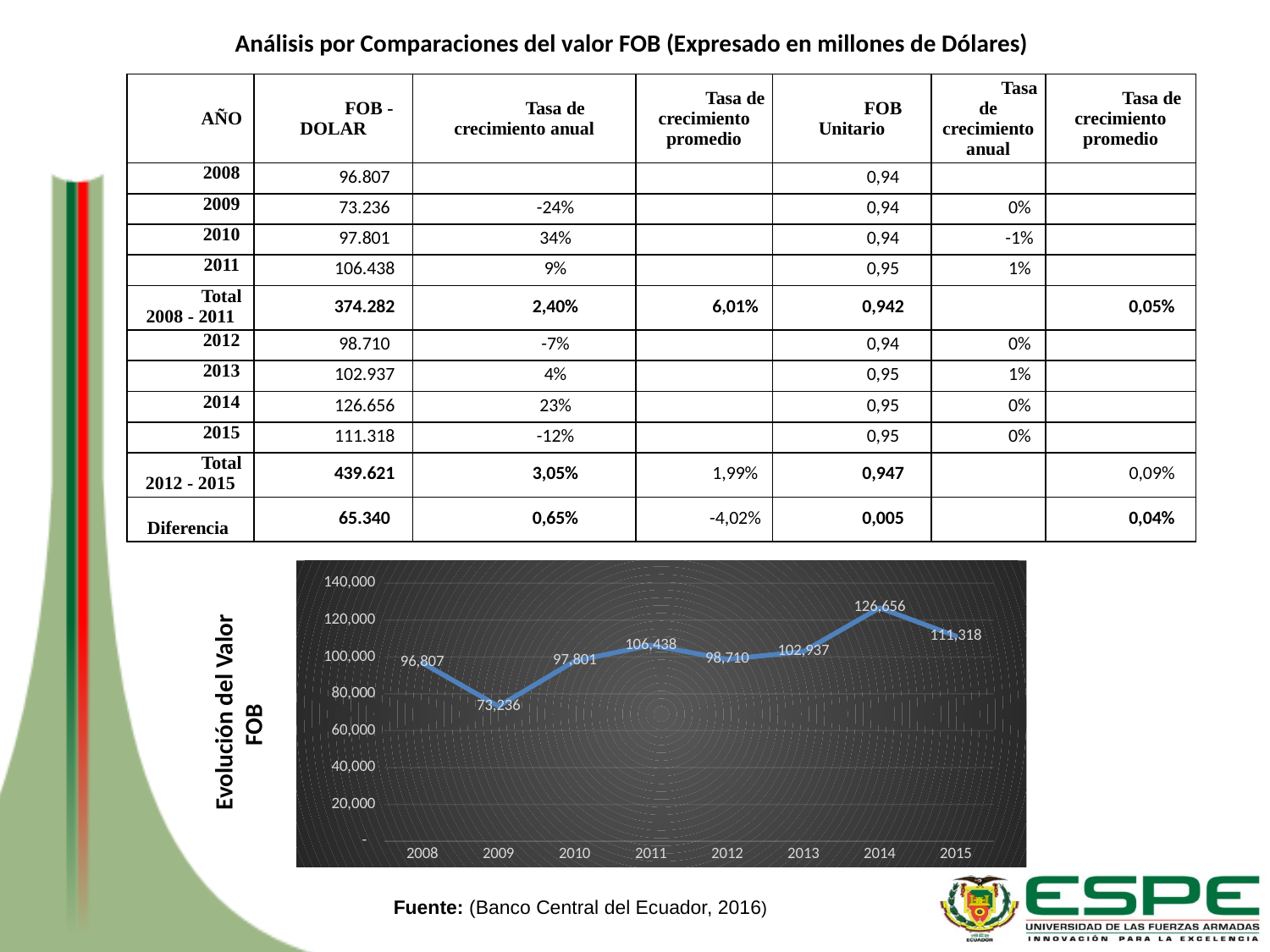
In the line chart, what is the difference between the FOB values for 2014 and 2015? 15,338 In the line chart, which year has a larger FOB value, 2010 or 2012? 2012 Which year has the highest FOB value in the line chart? 2014 What is the FOB value plotted for 2008 in the line chart? 96,807 In the line chart, is the FOB value for 2009 greater or less than 80,000? less In the line chart, does the FOB value rise or fall from 2012 to 2014? rise What is the FOB value plotted for 2014 in the line chart? 126,656 What is the title written beside the line chart? Evolución del Valor FOB What is the FOB value plotted for 2011 in the line chart? 106,438 What kind of chart is shown on the slide? line chart Which year has the lowest FOB value in the line chart? 2009 How many years are plotted on the x axis of the line chart? 8